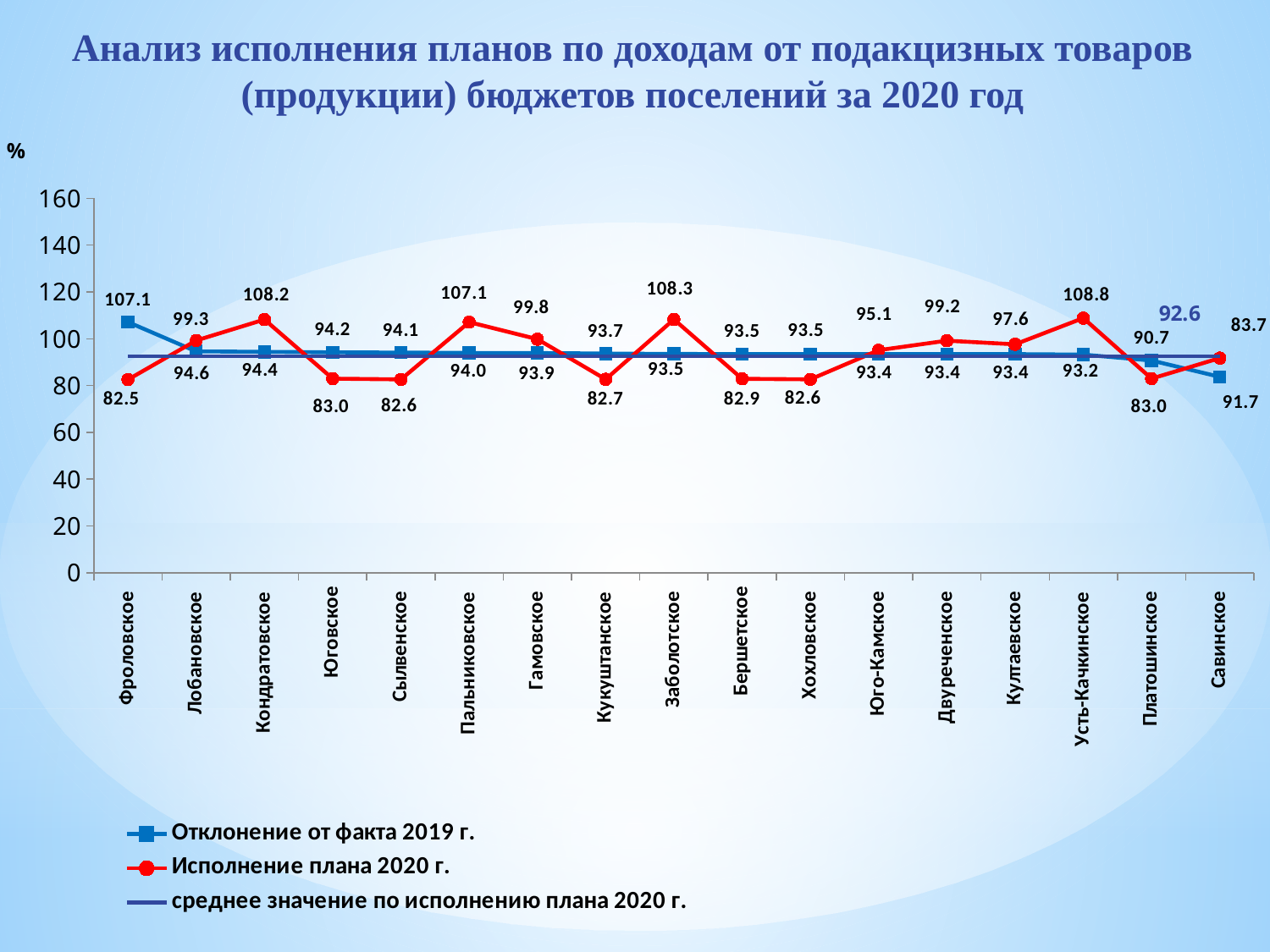
What is the value of 'Отклонение от факта 2019 г.' for Фроловское? 107.1 Which settlement has the lowest value for 'Отклонение от факта 2019 г.'? Савинское What type of chart is shown on the slide? line chart How many series does the legend list? 3 What is the value of 'Исполнение плана 2020 г.' for Усть-Качкинское? 108.8 What is the value of 'Исполнение плана 2020 г.' for Платошинское? 83.0 What is the value shown for 'среднее значение по исполнению плана 2020 г.'? 92.6 For Савинское, which is larger: 'Исполнение плана 2020 г.' or 'Отклонение от факта 2019 г.'? Исполнение плана 2020 г. Which settlement has the highest value for 'Исполнение плана 2020 г.'? Усть-Качкинское How many settlements (categories) are shown on the x axis? 17 Which settlement has the lowest value for 'Исполнение плана 2020 г.'? Фроловское What is the difference between 'Исполнение плана 2020 г.' and 'Отклонение от факта 2019 г.' for Заболотское? 14.8